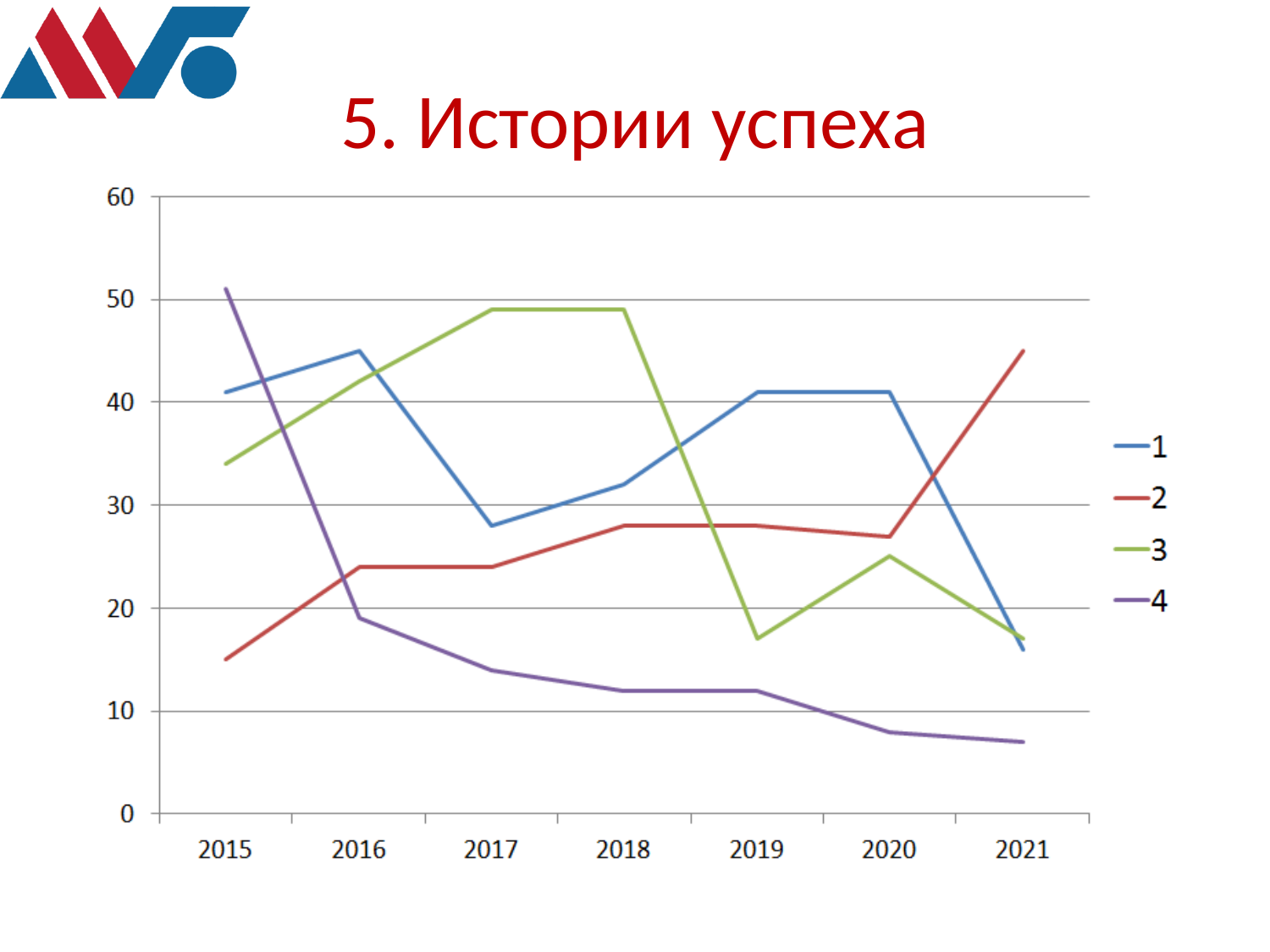
What is the title of the slide containing the chart? 5. Истории успеха Which series has the highest value in 2021? 2 Is the value for series 2 in 2015 greater or less than 20? less What kind of chart is shown on the slide? line chart Does the value for series 4 generally rise or fall from 2015 to 2021? fall How many years are shown on the x axis? 7 Is the value for series 3 in 2017 greater or less than 40? greater Is the value for series 4 in 2021 greater or less than 10? less In 2018, which is larger: the value for series 3 or the value for series 1? series 3 Which series has the lowest value in 2021? 4 How many series does the legend list? 4 Which series has the highest value in 2015? 4